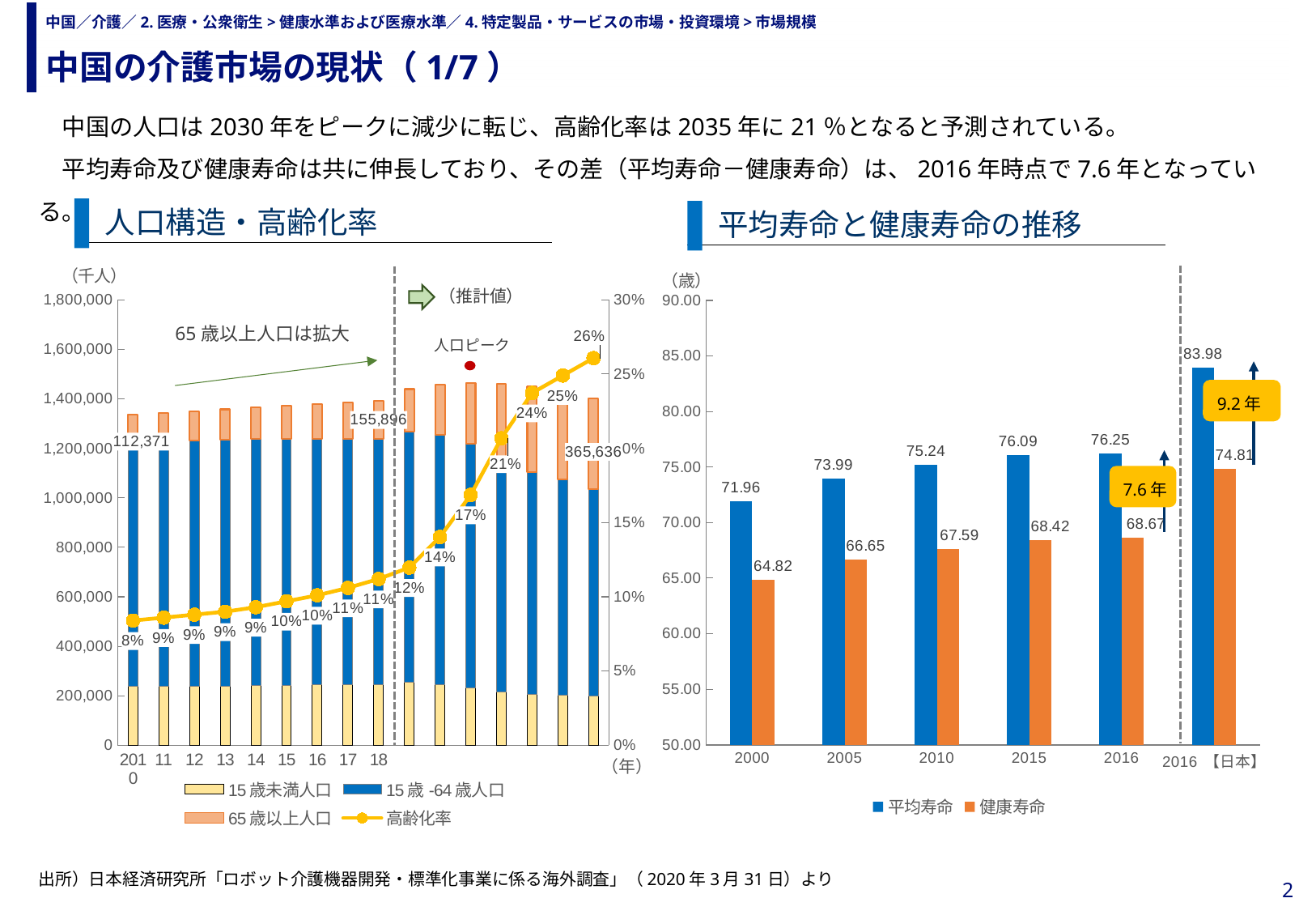
In the chart titled 人口構造・高齢化率, what is the 高齢化率 value for 2010? 8% In the chart titled 平均寿命と健康寿命の推移, what is the 平均寿命 value for 2010? 75.24 In the chart titled 平均寿命と健康寿命の推移, which category has the highest 健康寿命 value? 2016【日本】 In the chart titled 平均寿命と健康寿命の推移, which is larger: the 健康寿命 value for 2000 or for 2015? 2015 In the chart titled 平均寿命と健康寿命の推移, does the 平均寿命 value rise or fall from 2000 to 2016? Rises In the chart titled 平均寿命と健康寿命の推移, what is the difference between the 平均寿命 values for 2016 and 2000? 4.29 How many series does the legend of the chart titled 人口構造・高齢化率 list? 4 In the chart titled 平均寿命と健康寿命の推移, what is the 健康寿命 value for 2005? 66.65 How many series does the legend of the chart titled 平均寿命と健康寿命の推移 list? 2 In the chart titled 人口構造・高齢化率, what is the highest 高齢化率 value shown? 26% What kind of chart is the chart titled 平均寿命と健康寿命の推移? Bar chart In the chart titled 人口構造・高齢化率, what is the labelled 65歳以上人口 value for 2010? 112,371